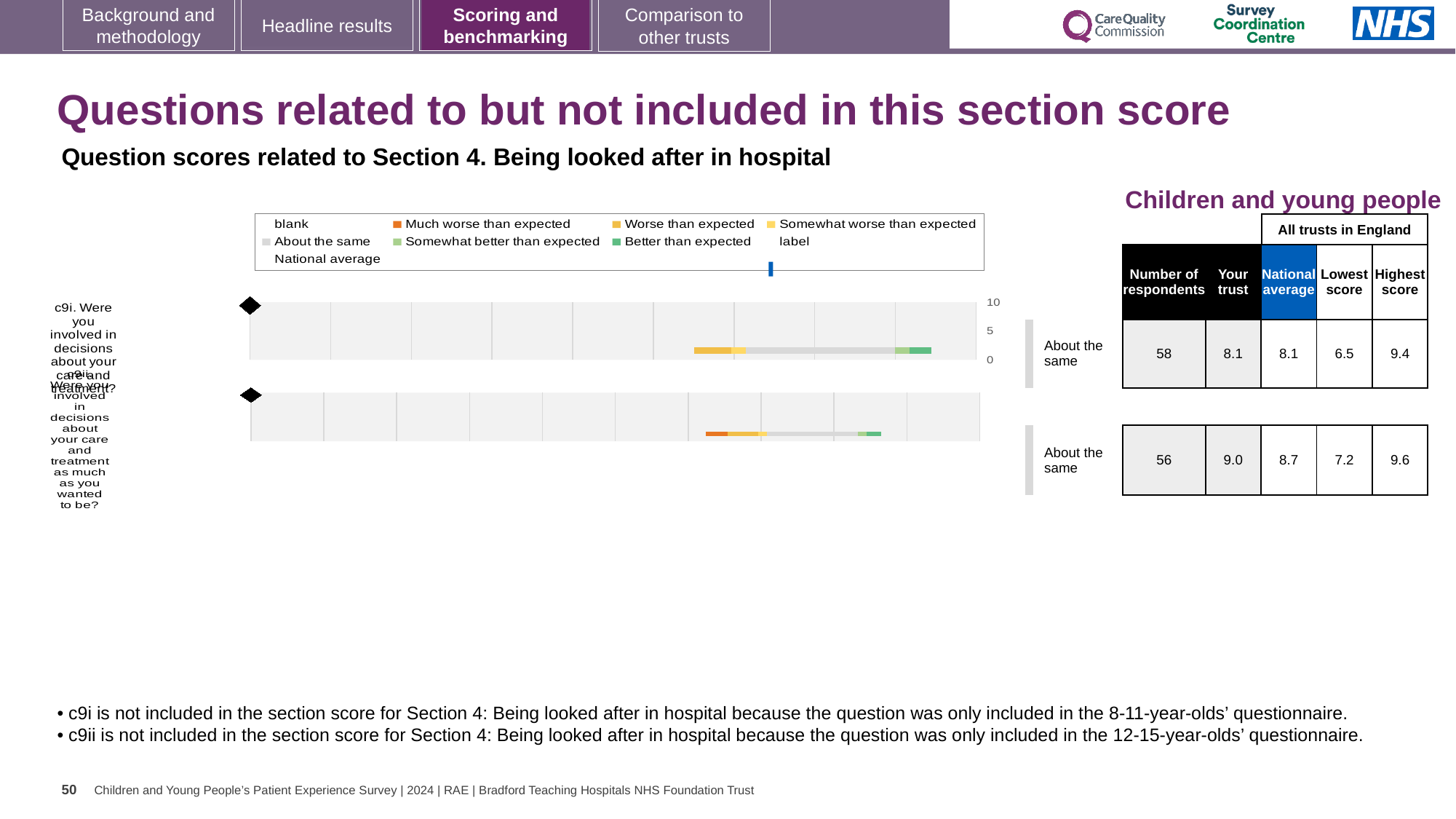
What benchmark rating is shown next to the c9i chart? About the same What benchmark rating is shown next to the c9ii chart? About the same Which legend entry is shown in orange? Much worse than expected What kind of chart is used to show the c9i and c9ii question scores? bar chart In the table beside the charts, what is the 'Your trust' score for c9i? 8.1 In the table beside the charts, what is the difference between the highest score and lowest score for c9i? 2.9 How many questions (charts) are plotted on the slide? 2 In the table beside the charts, what is the national average for c9ii? 8.7 On the c9i chart, is the left end of the coloured bar greater or less than 5 on the axis? greater In the table beside the charts, which question has the larger 'Your trust' score, c9i or c9ii? c9ii How many entries does the chart legend list? 9 In the table beside the charts, what is the 'Your trust' score for c9ii? 9.0